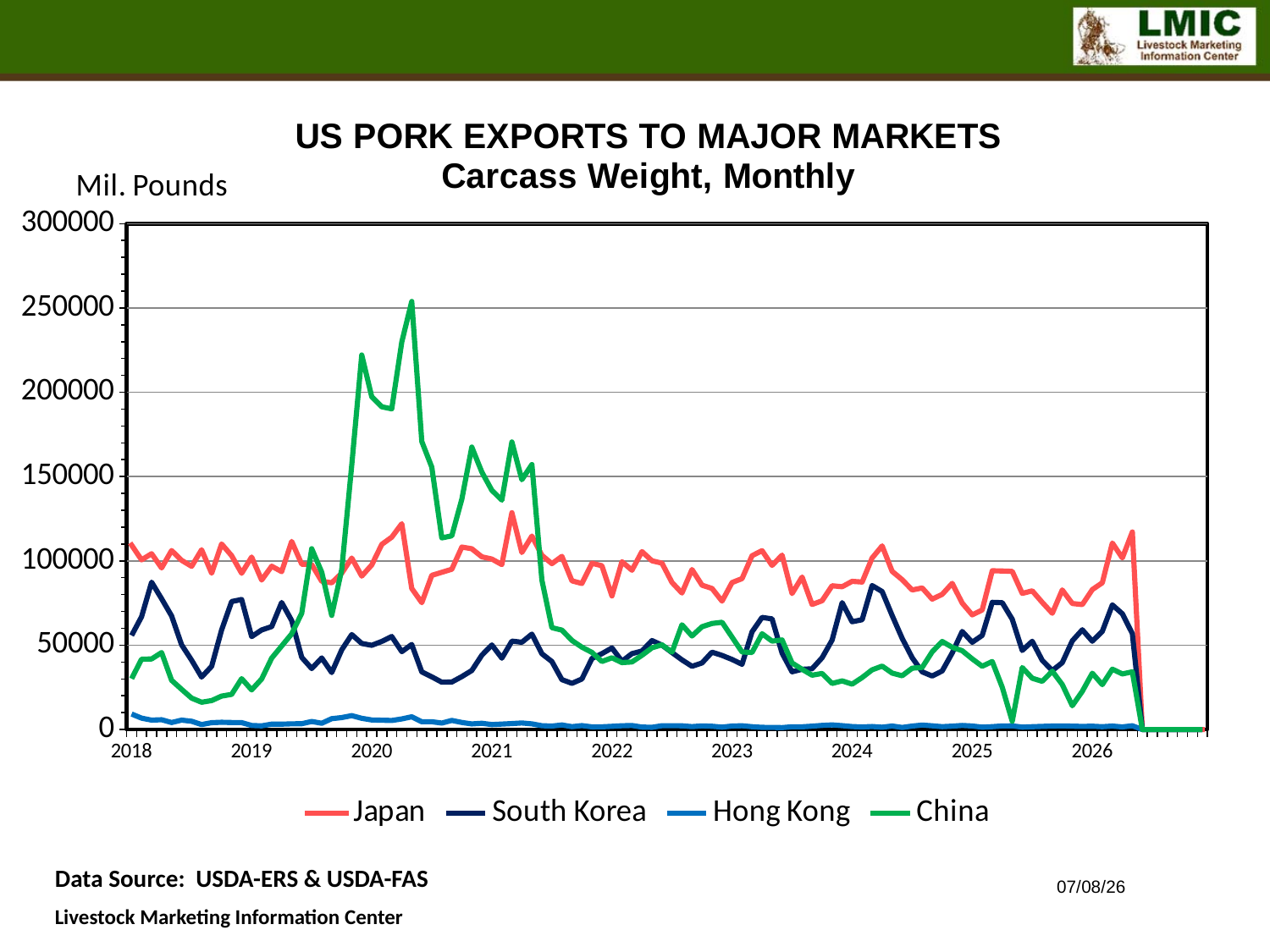
Which series reaches the highest value on the chart? China Which colour represents China in the legend? green Is the peak value for China greater or less than 200000? greater Is the peak value for South Korea greater or less than 100000? less What kind of chart is shown on the slide? line chart How many series does the legend list? 4 Is the highest value for Hong Kong greater or less than 50000? less Do the values for China rise or fall from their 2020 peak through 2022? fall Which series stays lowest across the whole chart? Hong Kong Which series is higher for most of 2018, Japan or South Korea? Japan What unit is shown on the y-axis label? Mil. Pounds